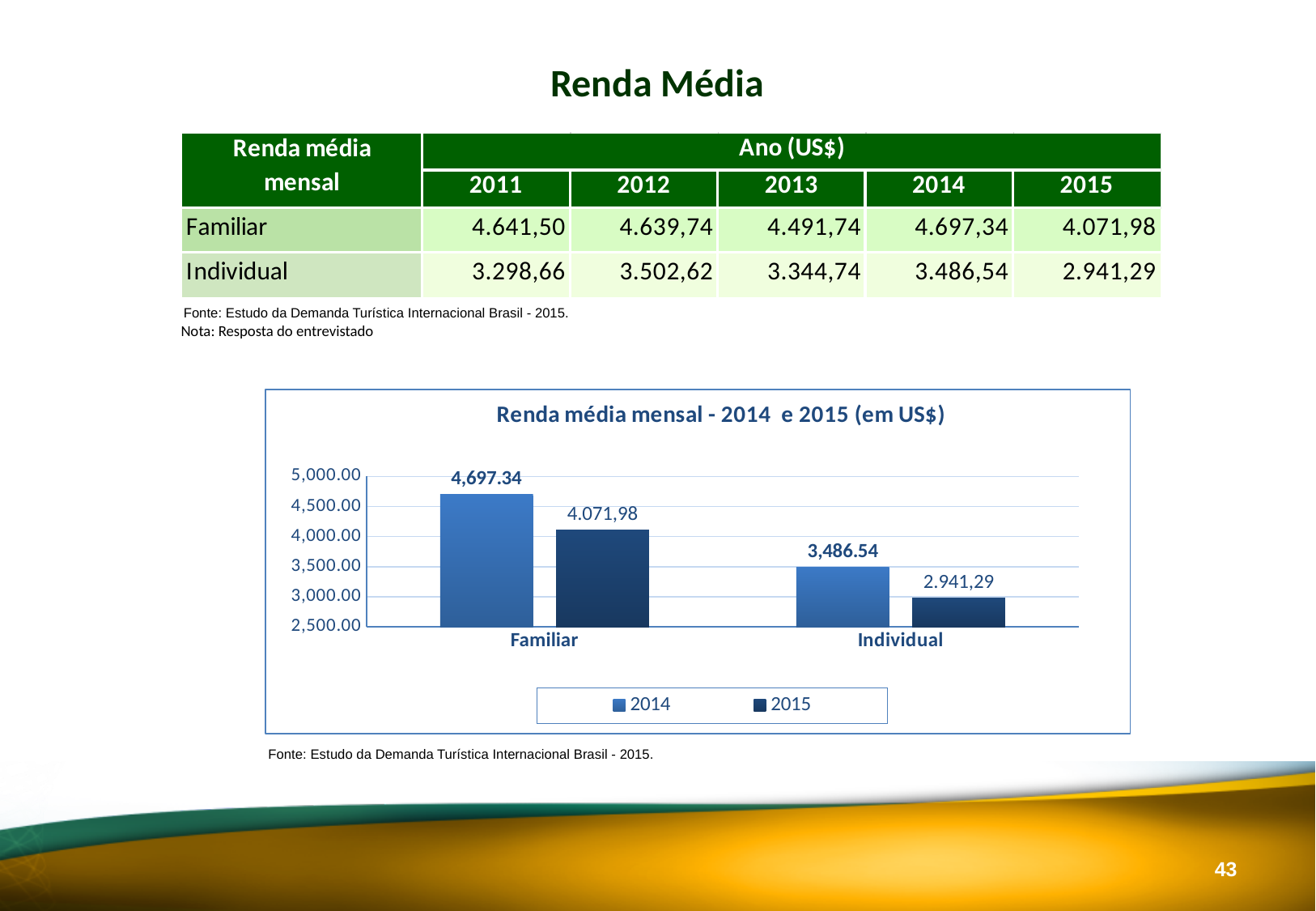
Which is larger for Individual: the 2014 value or the 2015 value? 2014 What is the title of the chart? Renda média mensal - 2014 e 2015 (em US$) How many series does the chart legend list? 2 What is the value for Familiar in 2015? 4.071,98 Which bar has the lowest value in the chart? Individual, 2015 What kind of chart is shown on the slide? bar chart What is the value for Individual in 2014? 3,486.54 How many categories are shown on the x axis of the chart? 2 What is the value for Familiar in 2014? 4,697.34 Which bar has the highest value in the chart? Familiar, 2014 What is the value for Individual in 2015? 2.941,29 Is the value for Familiar in 2015 greater or less than 4,500.00? less